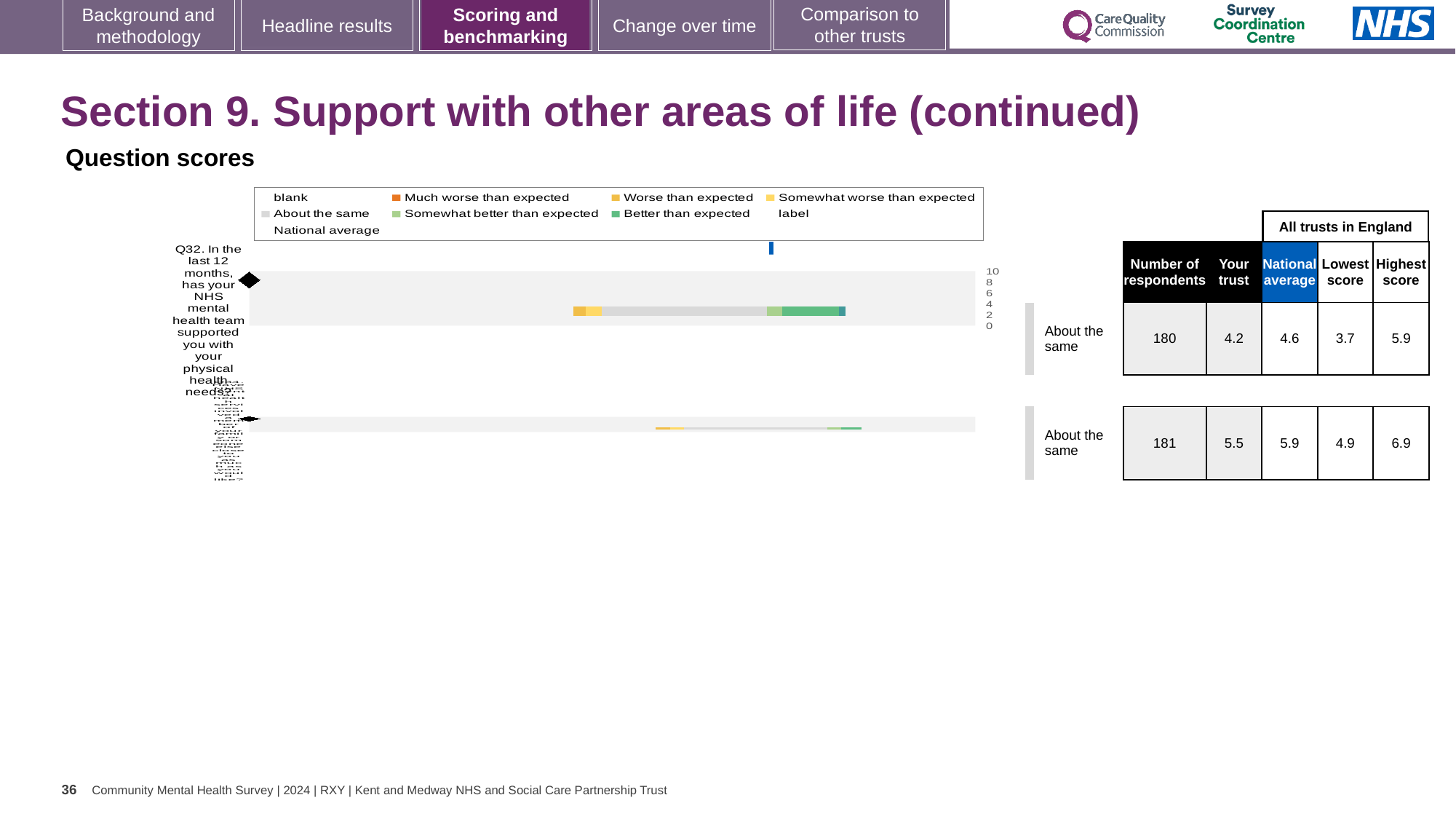
In the table beside the chart, what is the highest score among all trusts in England for Q32? 5.9 How many entries does the chart legend list? 9 What colour does the legend use for 'Much worse than expected'? orange In the table beside the chart, what is the 'Your trust' score for Q32? 4.2 In the table beside the chart, what is the number of respondents for Q32? 180 What benchmark category label is shown next to the Q32 bar? About the same For Q32, what is the difference between the national average and the 'Your trust' score? 0.4 What kind of chart is shown on the slide? bar chart For Q32, which is larger: the 'Your trust' score or the national average? National average In the table beside the chart, what is the national average for Q32? 4.6 How many questions are plotted as bars in the chart? 2 In the table beside the chart, what is the lowest score among all trusts in England for Q32? 3.7